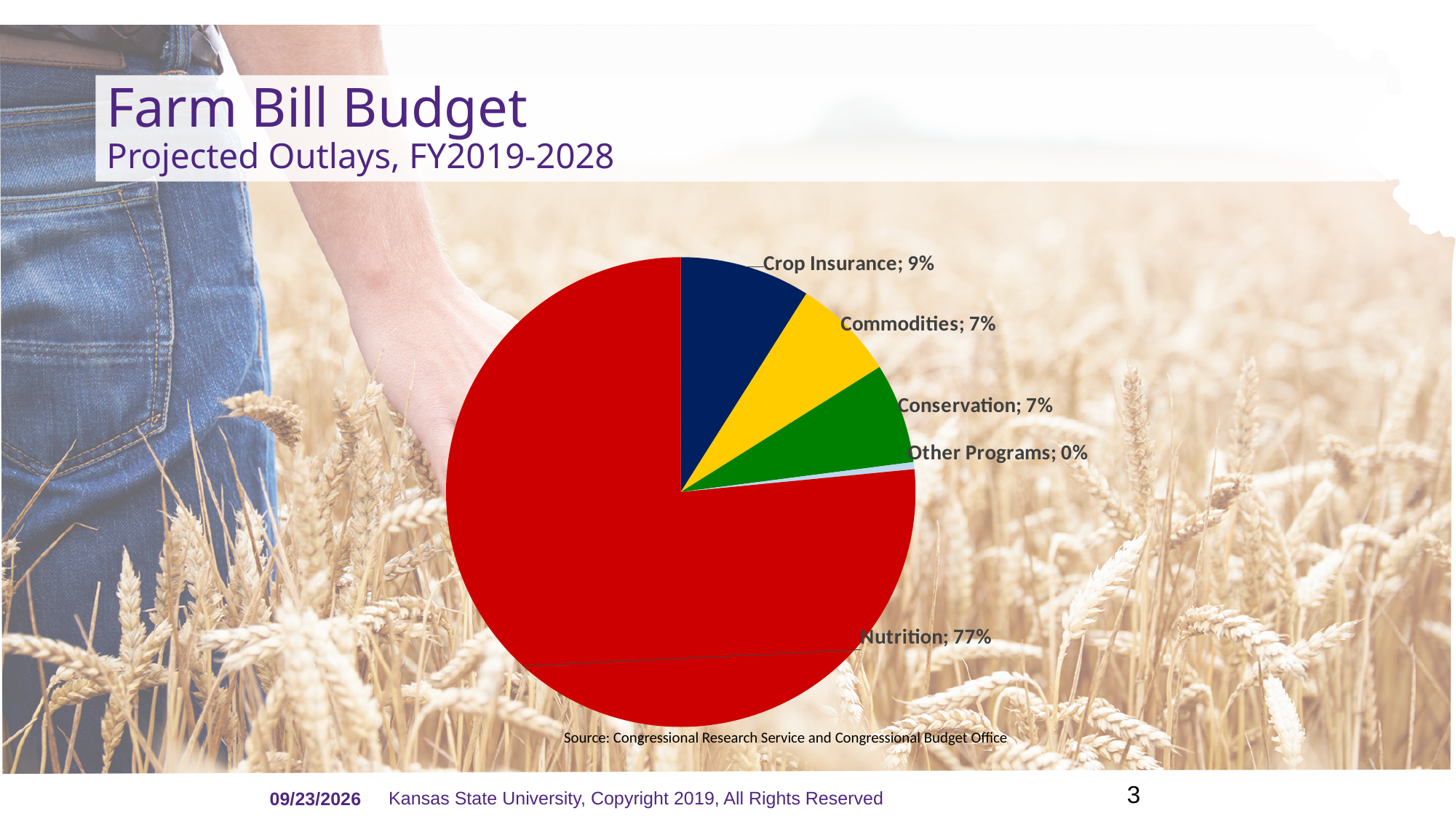
Which category has the smallest share of the pie? Other Programs What share of projected outlays goes to Commodities? 7% What share of projected outlays goes to Nutrition? 77% What colour is the Nutrition slice of the pie? red Which category has the largest share of the pie? Nutrition What share of projected outlays goes to Other Programs? 0% What is the difference in percentage points between Nutrition and Crop Insurance? 68 How many categories are shown in the pie chart? 5 What kind of chart is shown on the slide? pie chart Which is larger, the share for Crop Insurance or the share for Conservation? Crop Insurance What share of projected outlays goes to Crop Insurance? 9% What is the combined share of Commodities and Conservation? 14%